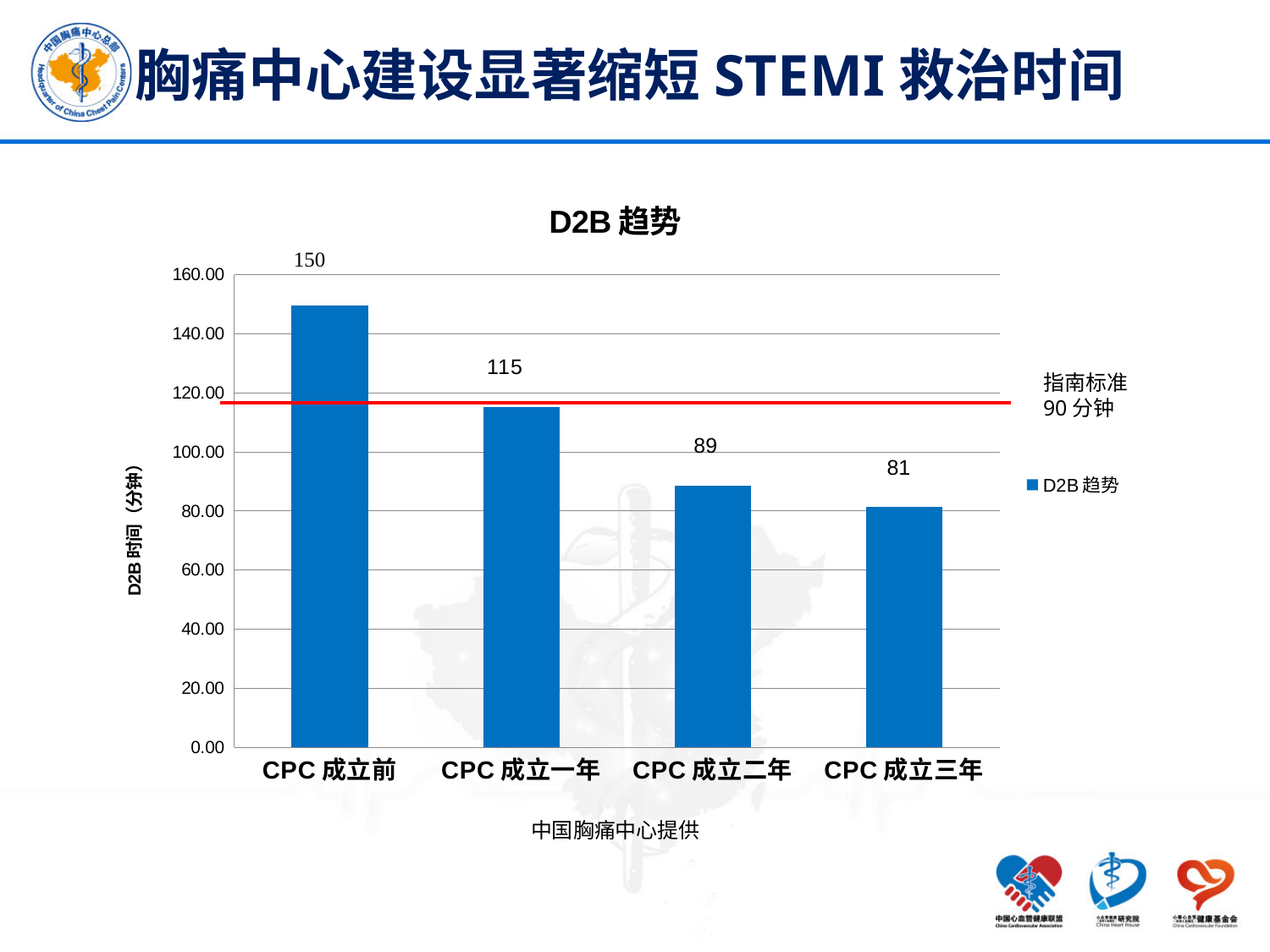
Which is larger, the D2B time for CPC 成立一年 or CPC 成立二年? CPC 成立一年 What is the difference between the D2B time for CPC 成立前 and CPC 成立三年? 69 How many categories are shown on the x axis? 4 Which category has the lowest D2B time? CPC 成立三年 What is the D2B time for CPC 成立前? 150 Which category has the highest D2B time? CPC 成立前 What is the title of the chart? D2B 趋势 What is the D2B time for CPC 成立三年? 81 Do the D2B values rise or fall from CPC 成立前 to CPC 成立三年? Fall What is the D2B time for CPC 成立二年? 89 What kind of chart is this? Bar chart What is the D2B time for CPC 成立一年? 115